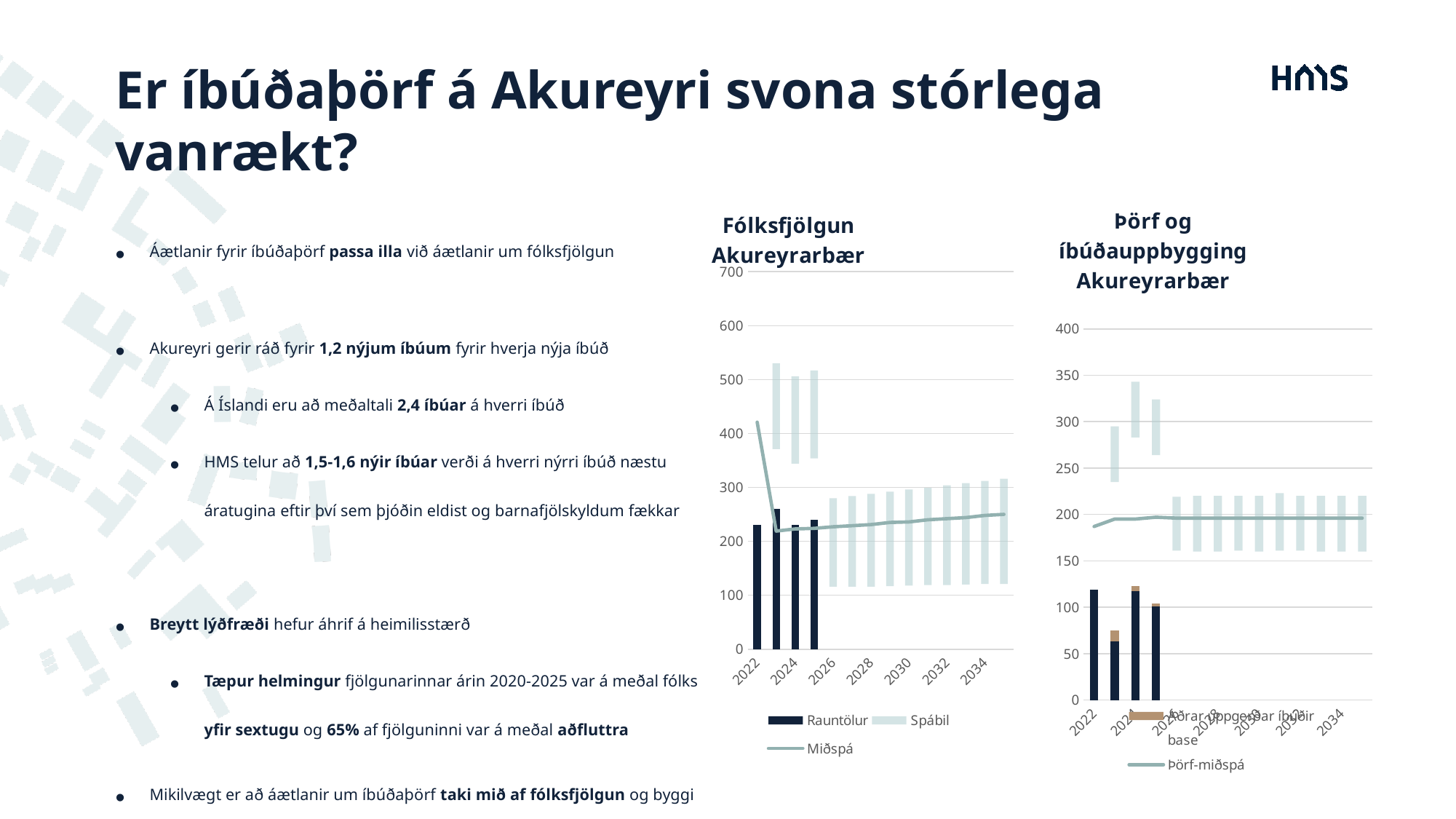
In the 'Fólksfjölgun Akureyrarbær' chart, is the Miðspá value for 2034 greater or less than 300? less What is the highest value shown on the y axis of the 'Þörf og íbúðauppbygging Akureyrarbær' chart? 400 In the 'Fólksfjölgun Akureyrarbær' chart, how many series does the legend list? 3 In the 'Fólksfjölgun Akureyrarbær' chart, how many dark Rauntölur bars are plotted? 4 What kind of chart is the 'Fólksfjölgun Akureyrarbær' chart? bar chart with a line In the 'Fólksfjölgun Akureyrarbær' chart, is the Rauntölur value for 2022 greater or less than 200? greater In the 'Þörf og íbúðauppbygging Akureyrarbær' chart, is the dark bar for 2023 greater or less than 100? less In the 'Þörf og íbúðauppbygging Akureyrarbær' chart, which year has the larger dark bar, 2022 or 2023? 2022 In the 'Fólksfjölgun Akureyrarbær' chart, which legend entry corresponds to the dark bars? Rauntölur In the 'Fólksfjölgun Akureyrarbær' chart, does the Miðspá line rise or fall from 2026 to 2034? rise